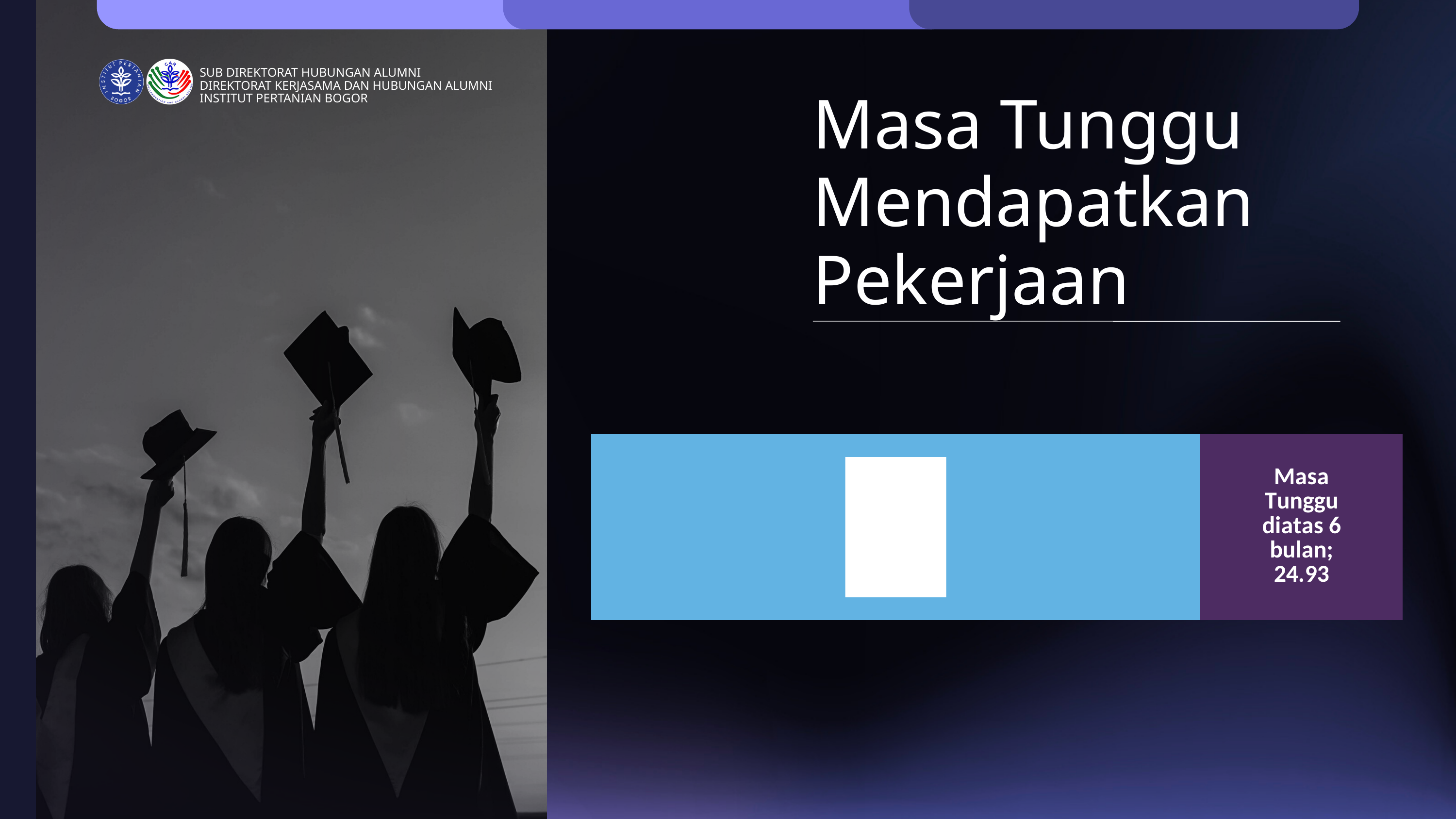
What colour is the segment labelled "Masa Tunggu diatas 6 bulan"? purple Which segment of the bar is the smaller one, the light blue one or the purple one? the purple one What value is shown for the segment labelled "Masa Tunggu diatas 6 bulan"? 24.93 What kind of chart is shown on the slide? bar chart How many segments make up the bar in the chart? 2 Is the light blue segment of the bar larger or smaller than the purple segment? larger What is the title shown above the chart on the slide? Masa Tunggu Mendapatkan Pekerjaan